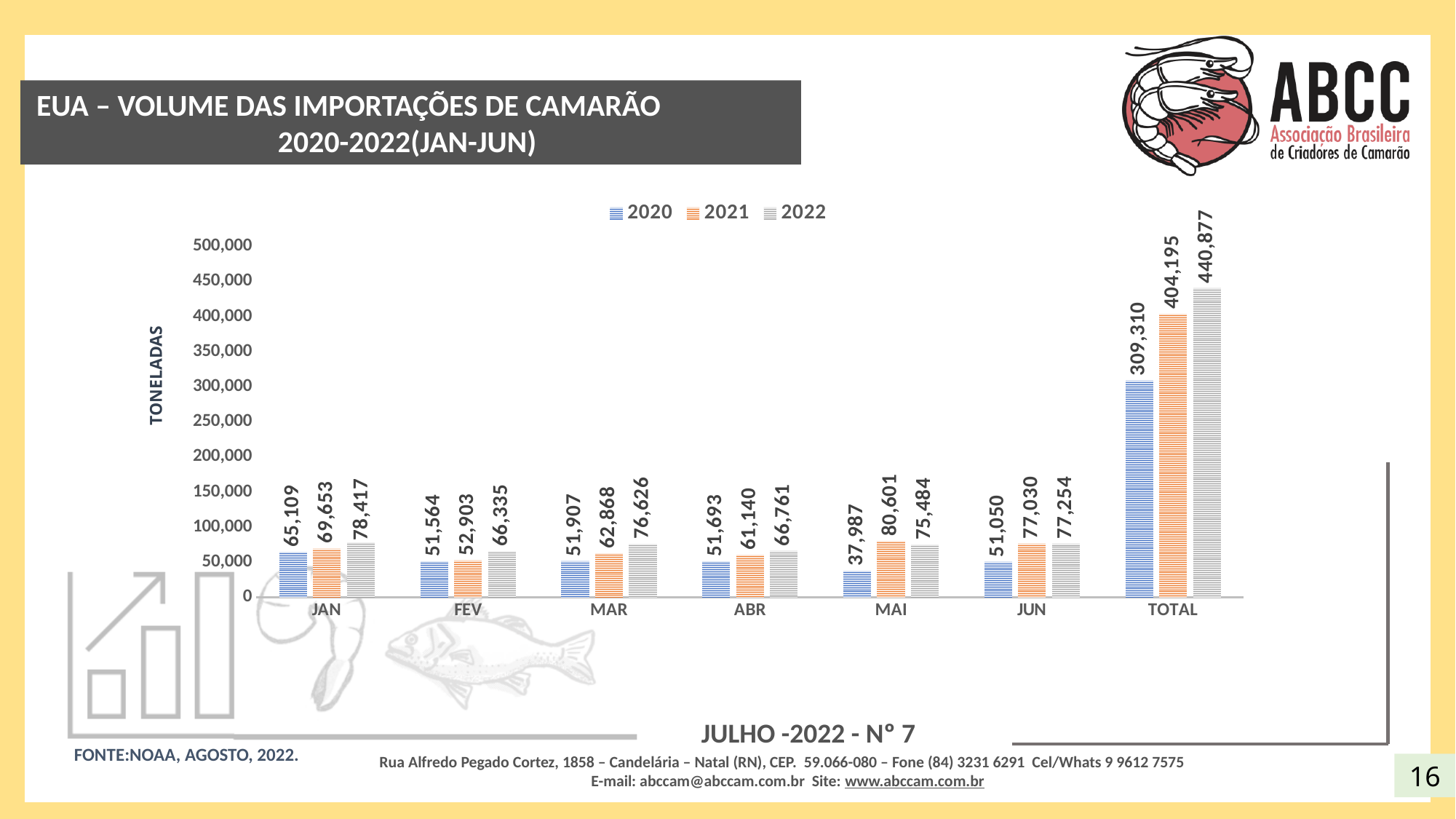
How many series does the legend list? 3 What is the value for 2022 in MAR? 76,626 What is the value for 2020 in MAI? 37,987 What is the value for 2021 in JUN? 77,030 What kind of chart is shown on the slide? bar chart What is the title of the vertical axis? TONELADAS Which month has the lowest value for the 2020 series? MAI How many categories are shown on the x axis? 7 Is the TOTAL value for 2020 greater or less than 300,000? greater What is the difference between the TOTAL values for 2022 and 2021? 36,682 Which series has the highest TOTAL value? 2022 For the 2021 series, which is larger: JAN or FEV? JAN